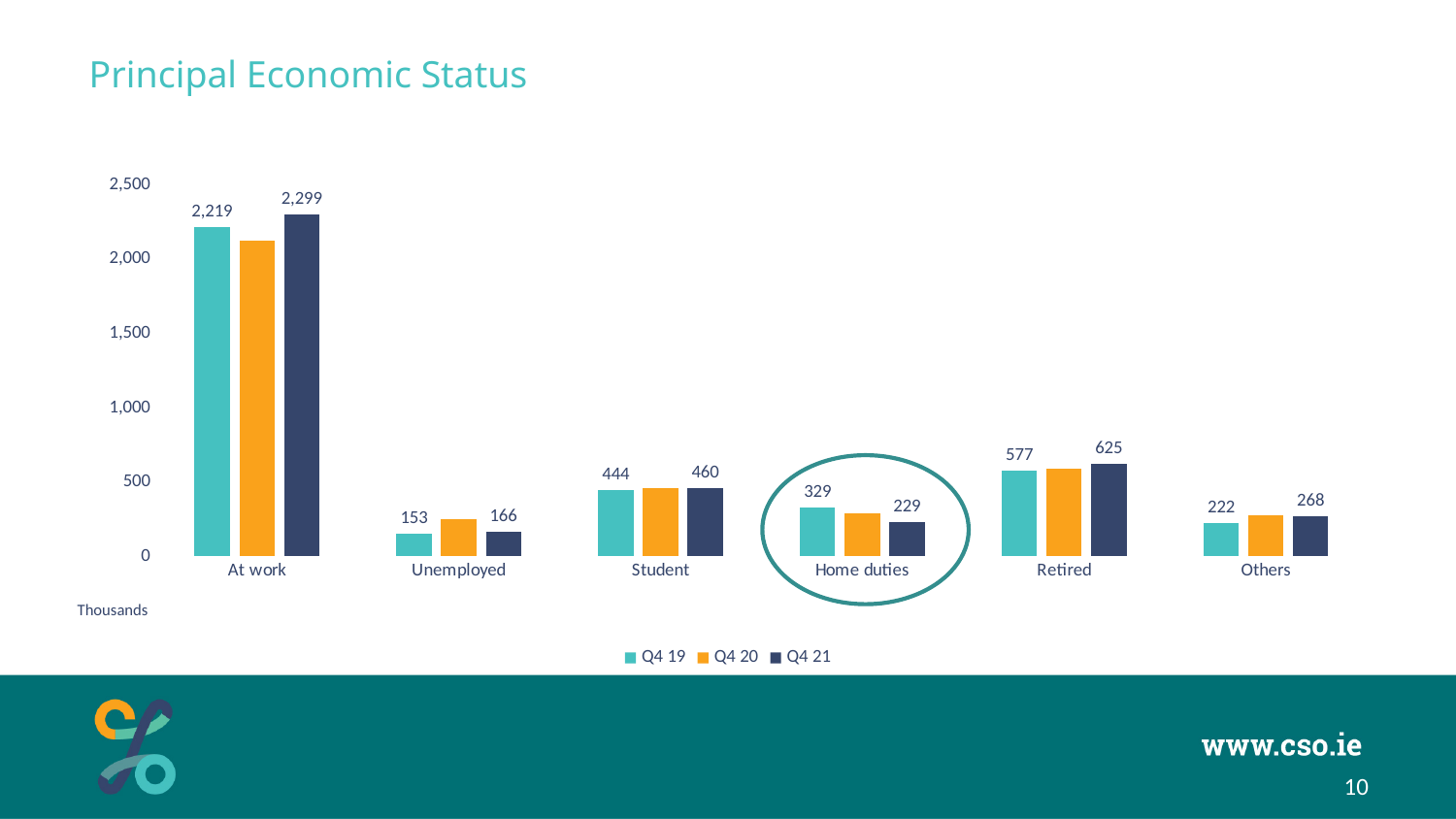
By how much did the Home duties value fall from Q4 19 to Q4 21? 100 Which is larger in Q4 21: Student or Retired? Retired How many categories are shown on the x axis? 6 By how much did the At work value increase from Q4 19 to Q4 21? 80 What is the Q4 21 value for Retired? 625 Which category is circled on the chart? Home duties Which category has the lowest Q4 19 value? Unemployed What is the Q4 21 value for Home duties? 229 What is the Q4 19 value for At work? 2,219 Which category has the highest Q4 21 value? At work How many series does the legend list? 3 Is the Q4 20 value for At work greater or less than 2,000? greater